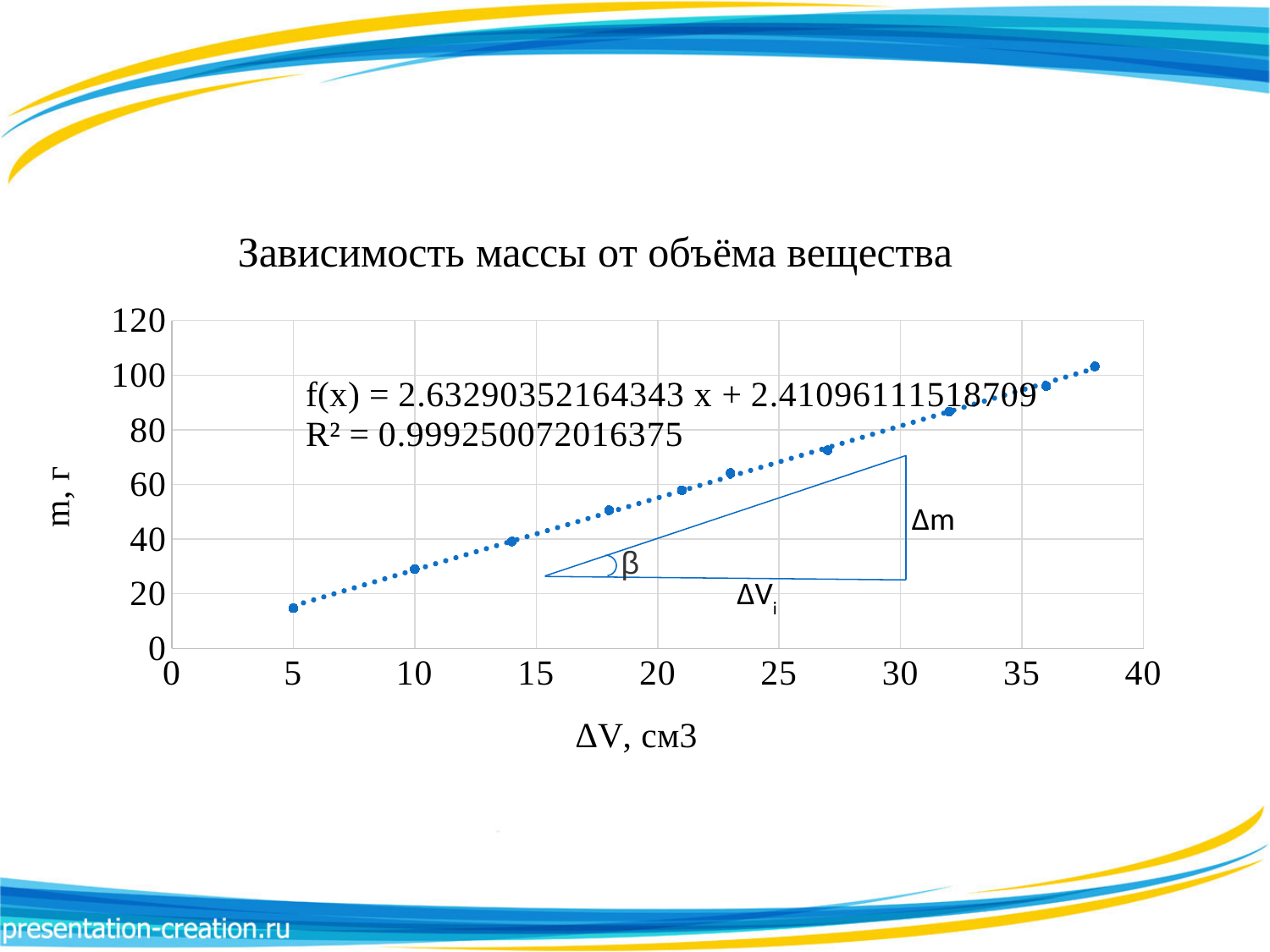
Is the value of m at ΔV = 38 greater or less than 100? greater What is the R² value shown for the trendline? 0.999250072016375 What type of chart is shown on the slide? scatter chart Is the value of m at ΔV = 27 greater or less than 80? less What is the label of the x axis? ΔV, см3 Is the value of m at ΔV = 18 greater or less than 40? greater What is the title of the chart? Зависимость массы от объёма вещества Which plotted point has the highest value of m: the one at ΔV = 5 or the one at ΔV = 38? ΔV = 38 How many data points are plotted on the chart? 10 What is the maximum value shown on the y axis? 120 Do the values of m rise or fall as ΔV increases along the x axis? rise